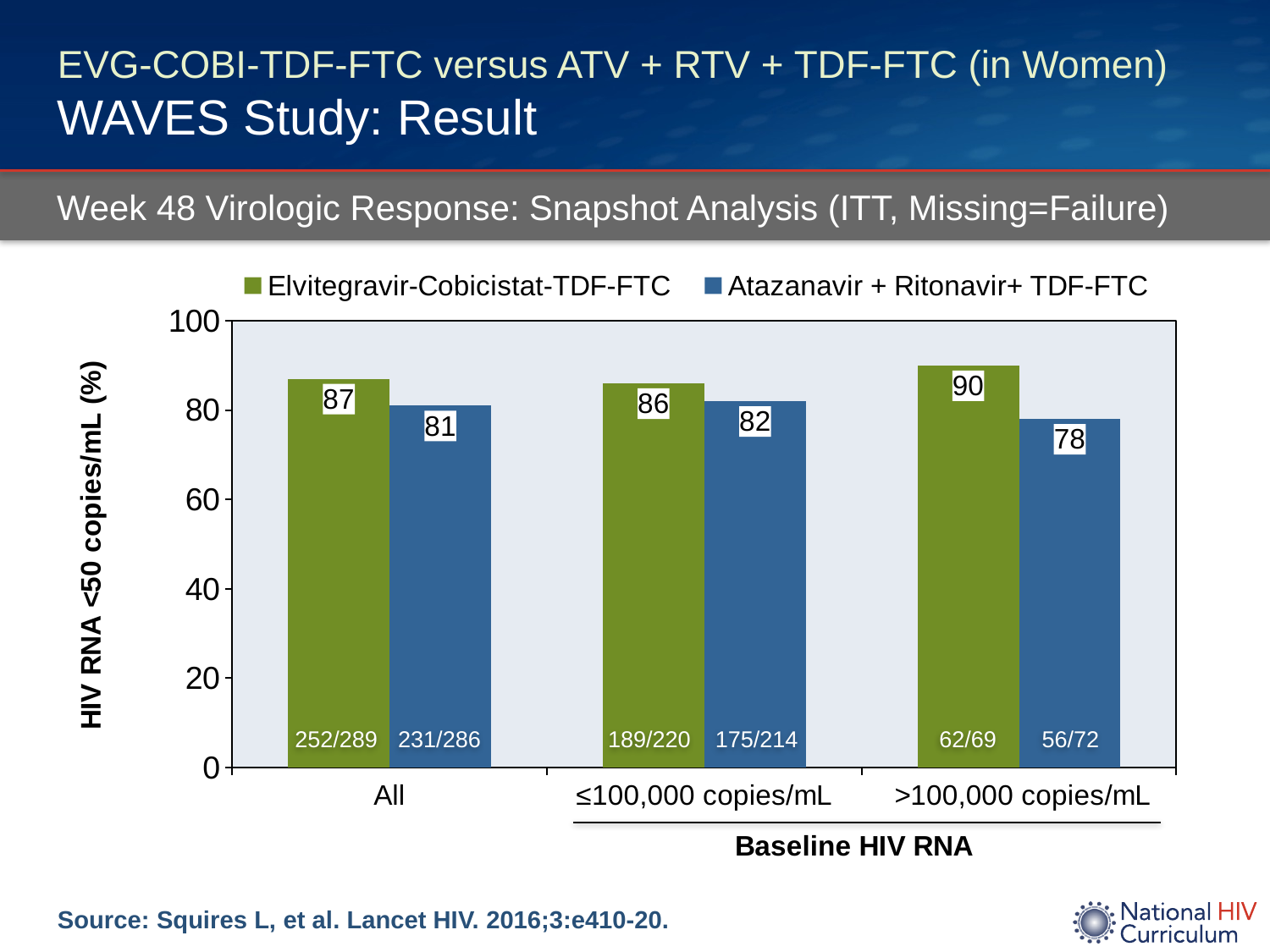
In which baseline HIV RNA category is the Elvitegravir-Cobicistat-TDF-FTC value highest? >100,000 copies/mL Which series has the larger value in the ≤100,000 copies/mL category? Elvitegravir-Cobicistat-TDF-FTC Is the value for Atazanavir + Ritonavir+ TDF-FTC in the All category greater or less than 60? greater What kind of chart is shown on the slide? Bar chart What is the difference between the Elvitegravir-Cobicistat-TDF-FTC and Atazanavir + Ritonavir+ TDF-FTC values in the All category? 6 How many categories are shown on the x axis? 3 What is the value for Atazanavir + Ritonavir+ TDF-FTC in the >100,000 copies/mL category? 78 What is the difference between the Elvitegravir-Cobicistat-TDF-FTC and Atazanavir + Ritonavir+ TDF-FTC values in the >100,000 copies/mL category? 12 What is the value for Elvitegravir-Cobicistat-TDF-FTC in the All category? 87 How many series does the legend list? 2 In which category is the Atazanavir + Ritonavir+ TDF-FTC value lowest? >100,000 copies/mL What is the value for Atazanavir + Ritonavir+ TDF-FTC in the ≤100,000 copies/mL category? 82